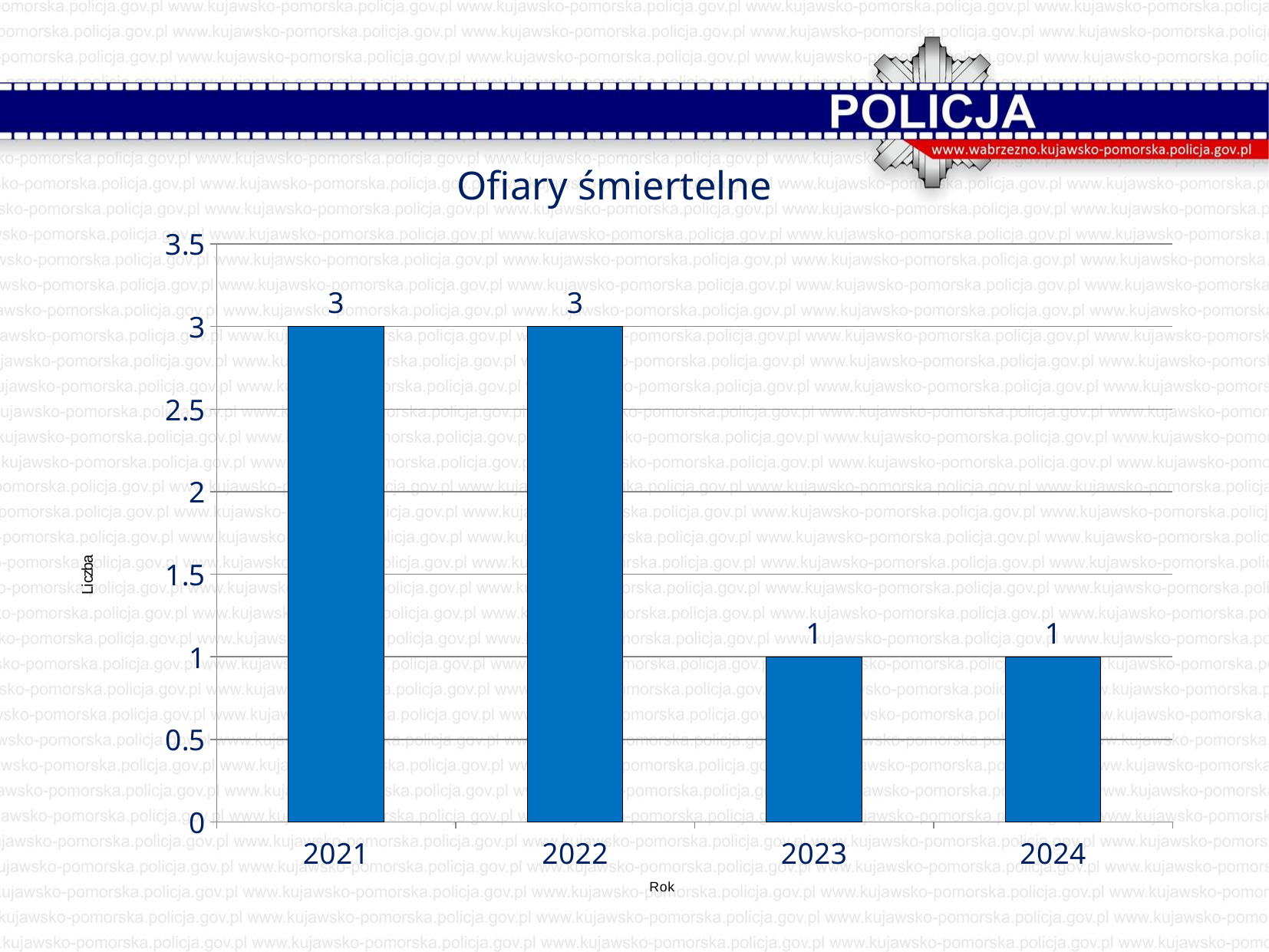
What is the total of the values for 2023 and 2024? 2 What is the value for 2021? 3 What kind of chart is this? bar chart What is the value for 2024? 1 What is the title of the chart? Ofiary śmiertelne Which is larger, the value for 2021 or the value for 2024? 2021 What is the difference between the values for 2022 and 2023? 2 What is the label of the x axis? Rok What is the value for 2023? 1 How many years are shown on the x axis? 4 Do the values rise or fall from 2022 to 2023? fall Is the value for 2022 greater or less than 2? greater